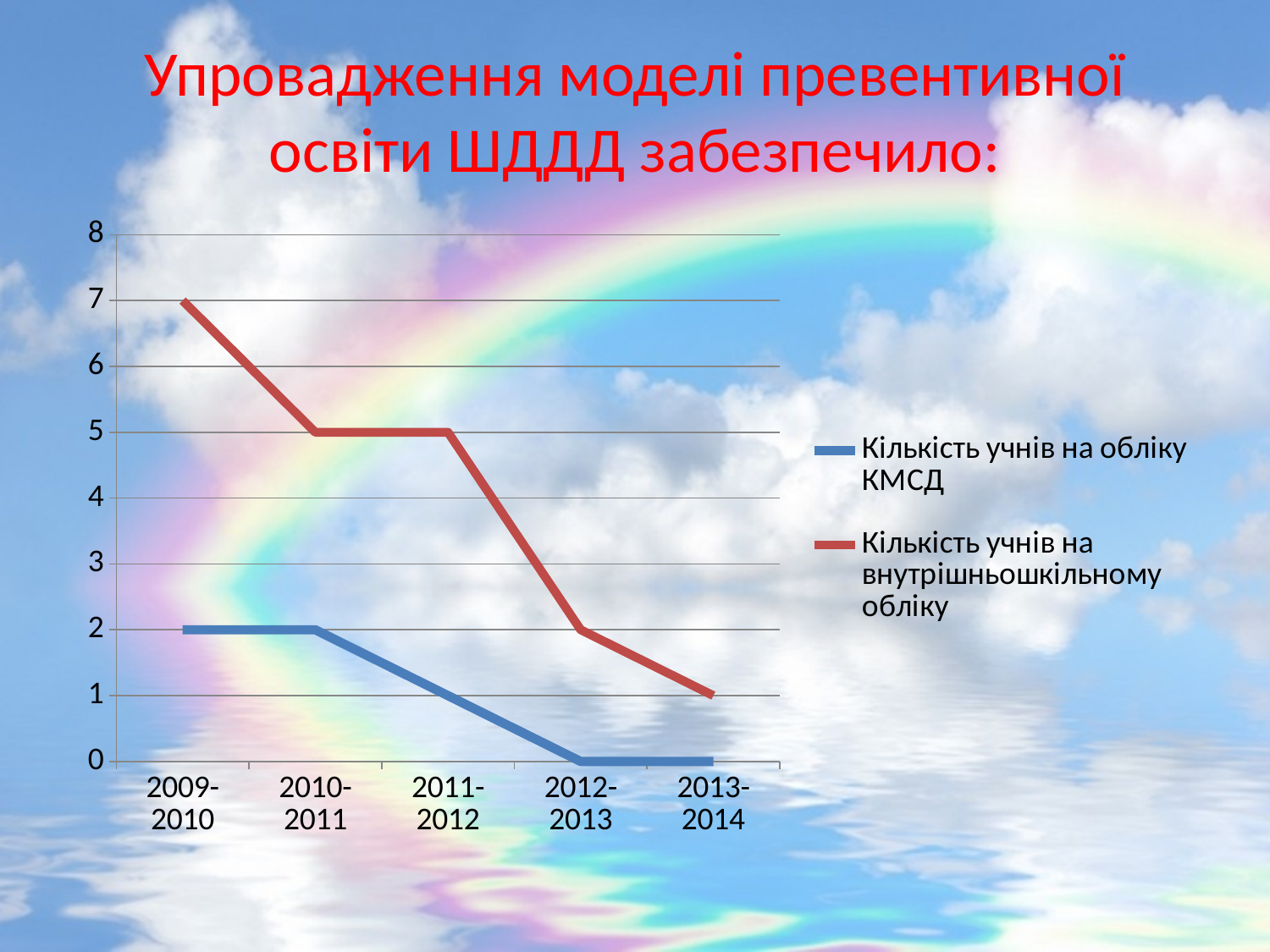
How many school-year categories are shown on the x axis? 5 What is the difference between 'Кількість учнів на внутрішньошкільному обліку' in 2009-2010 and in 2013-2014? 6 What is the value of 'Кількість учнів на обліку КМСД' for 2012-2013? 0 In which school year is 'Кількість учнів на внутрішньошкільному обліку' highest? 2009-2010 Which series has the larger value in 2011-2012? Кількість учнів на внутрішньошкільному обліку Do the values of 'Кількість учнів на внутрішньошкільному обліку' rise or fall from 2009-2010 to 2013-2014? fall What is the value of 'Кількість учнів на внутрішньошкільному обліку' for 2009-2010? 7 How many series does the legend list? 2 In which school year is 'Кількість учнів на внутрішньошкільному обліку' lowest? 2013-2014 What is the value of 'Кількість учнів на обліку КМСД' for 2010-2011? 2 What is the value of 'Кількість учнів на внутрішньошкільному обліку' for 2013-2014? 1 What kind of chart is shown on the slide? line chart